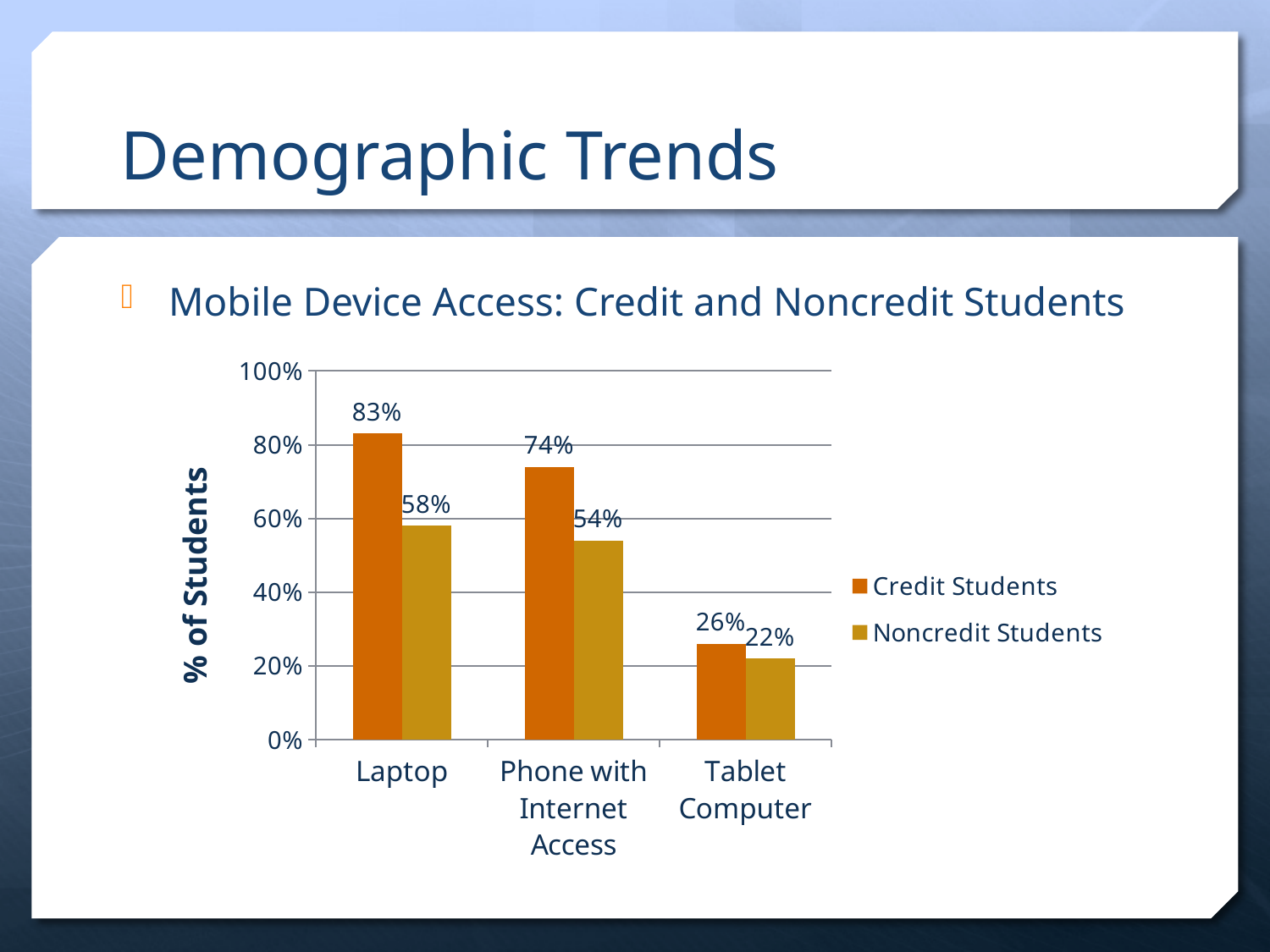
What kind of chart is shown on the slide? Bar chart How many device categories are shown on the x axis? 3 Which device category has the lowest value for Noncredit Students? Tablet Computer What is the difference between Credit Students and Noncredit Students for Laptop? 25% What is the difference between Credit Students and Noncredit Students for Phone with Internet Access? 20% What is the label on the vertical axis of the chart? % of Students What is the value for Noncredit Students in the Tablet Computer category? 22% What percentage of Noncredit Students have a phone with internet access? 54% Which is larger: Credit Students for Tablet Computer or Noncredit Students for Laptop? Noncredit Students for Laptop Which device category has the highest value for Credit Students? Laptop How many series does the legend list? 2 What percentage of Credit Students have a laptop? 83%